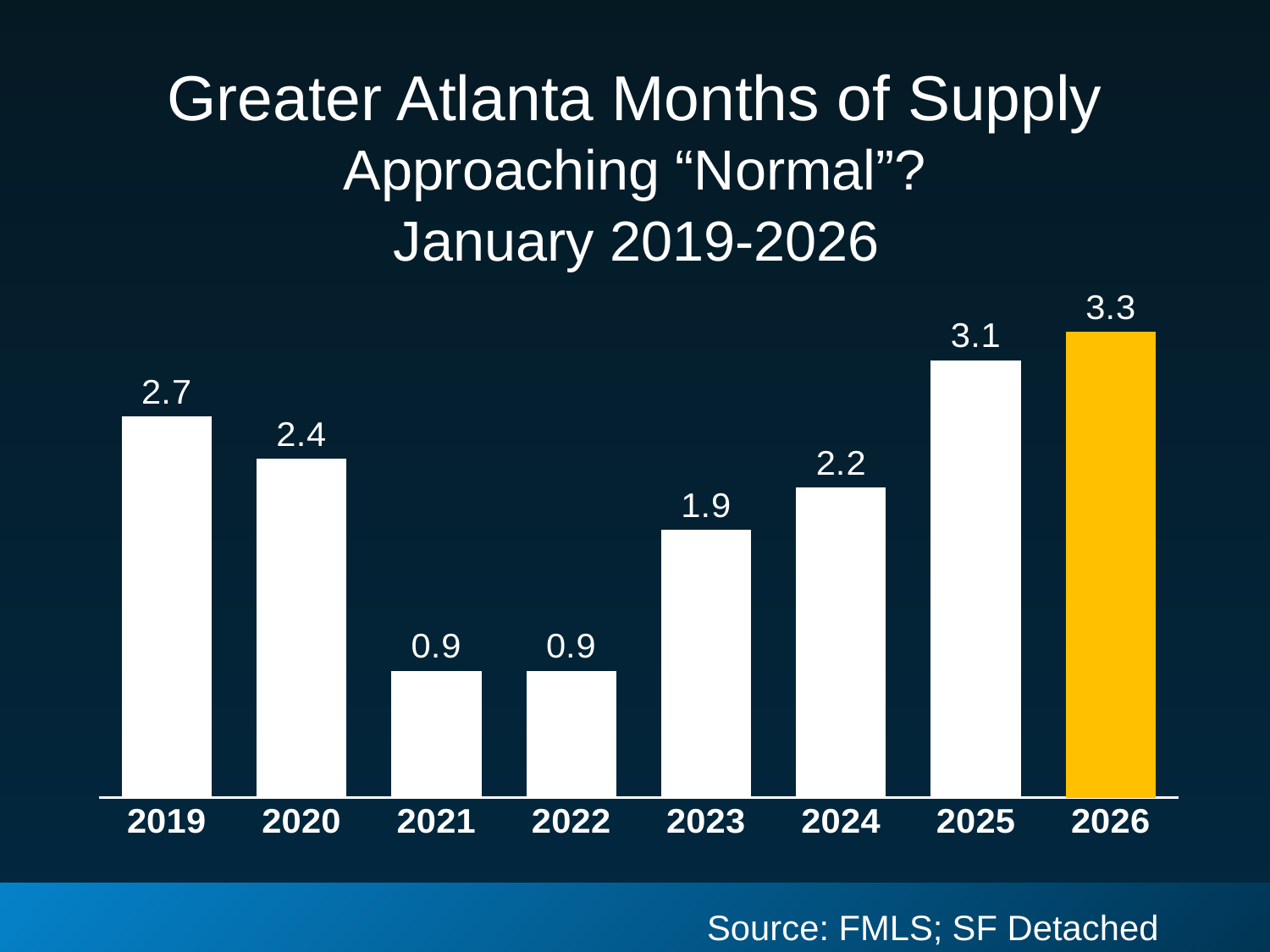
What is the difference between the 2026 value and the 2025 value? 0.2 What is the difference between the 2019 value and the 2021 value? 1.8 How many years are shown on the x axis? 8 Which is larger, the value for 2020 or the value for 2024? 2020 Which years share the lowest months of supply value? 2021 and 2022 What is the months of supply value for 2026? 3.3 What is the months of supply value for 2023? 1.9 What kind of chart is shown on the slide? Bar chart Which bar is coloured differently from the others? 2026 Which year has the highest months of supply? 2026 What is the months of supply value for 2019? 2.7 Do the values rise or fall from 2022 to 2026? Rise